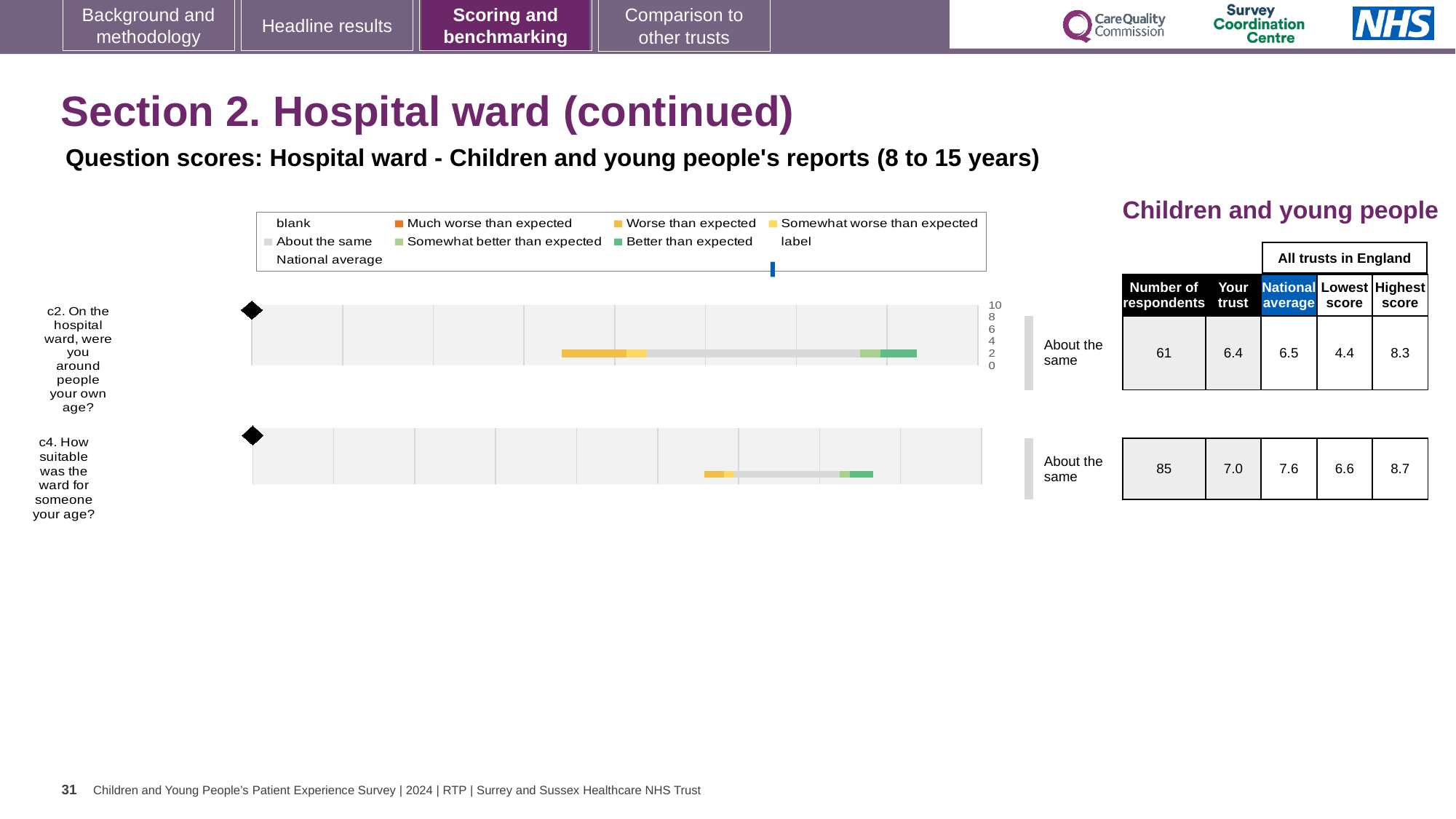
How many respondents answered question c2? 61 Is the 'Your trust' score for question c2 greater or less than 6? greater What is the national average score for question c4 (How suitable was the ward for someone your age?)? 7.6 How many questions are plotted in the chart on this slide? 2 What colour does the legend use for 'Better than expected'? green What is the 'Your trust' score for question c2 (On the hospital ward, were you around people your own age?)? 6.4 What is the difference between the highest score and the lowest score for question c2? 3.9 Which question has the higher 'Your trust' score, c2 or c4? c4 For question c4, how much higher is the national average than the 'Your trust' score? 0.6 What is the highest score across all trusts in England for question c4? 8.7 What kind of chart is used to show the question scores on this slide? bar chart What benchmark category is shown for question c2? About the same